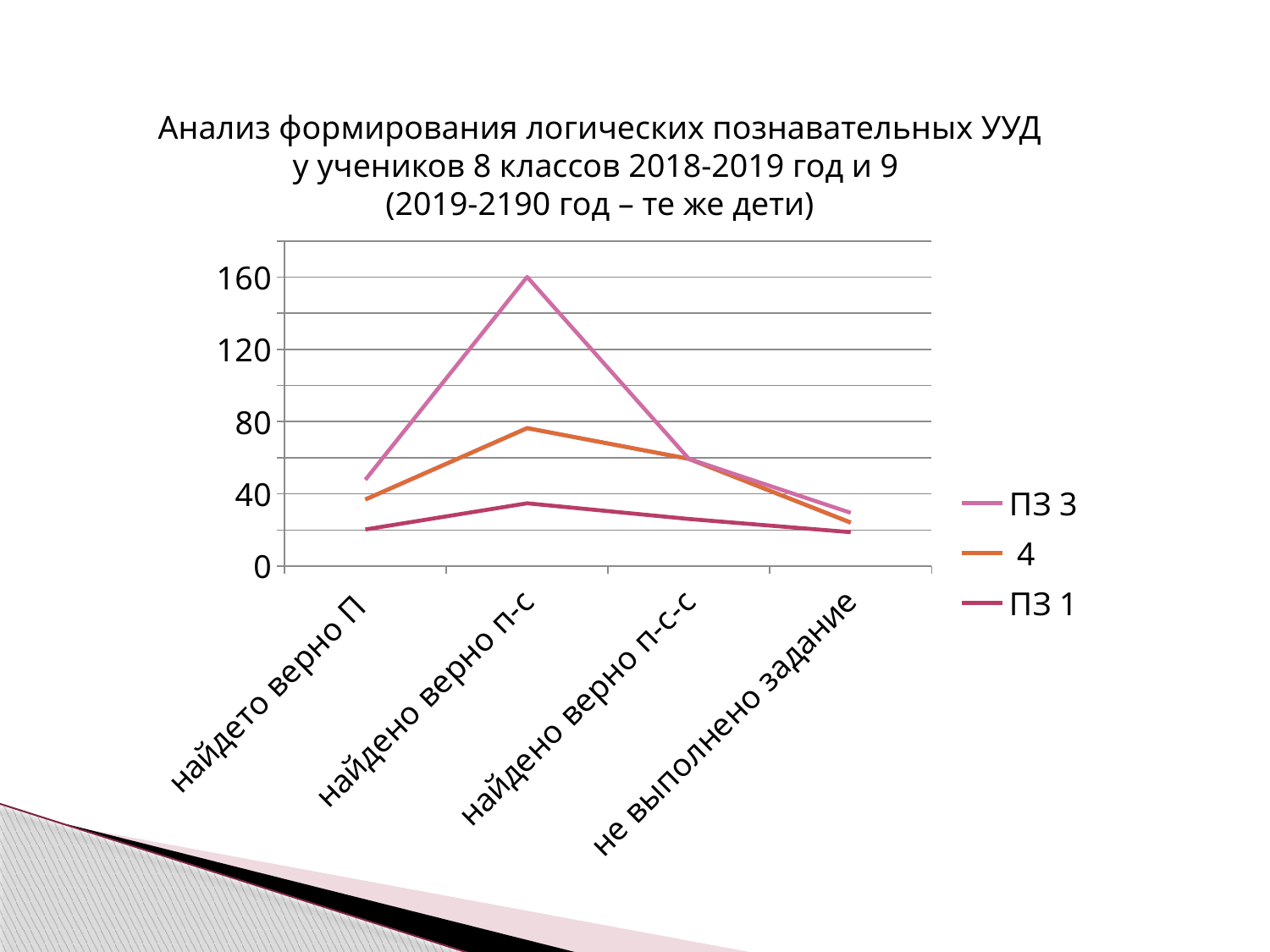
How many series does the legend list? 3 How many categories are shown on the x axis? 4 For which category does the ПЗ 3 series reach its highest value? найдено верно п-с Which series has the larger value for "найдено верно п-с", ПЗ 3 or ПЗ 1? ПЗ 3 Is the value of the series 4 for "найдено верно п-с" greater or less than 40? greater For which category does the ПЗ 3 series have its lowest value? не выполнено задание Is the value of ПЗ 3 for "найдето верно П" greater or less than 40? greater What kind of chart is shown on the slide? line chart Is the value of ПЗ 3 for "найдено верно п-с-с" greater or less than 80? less Which series are listed in the legend? ПЗ 3, 4, ПЗ 1